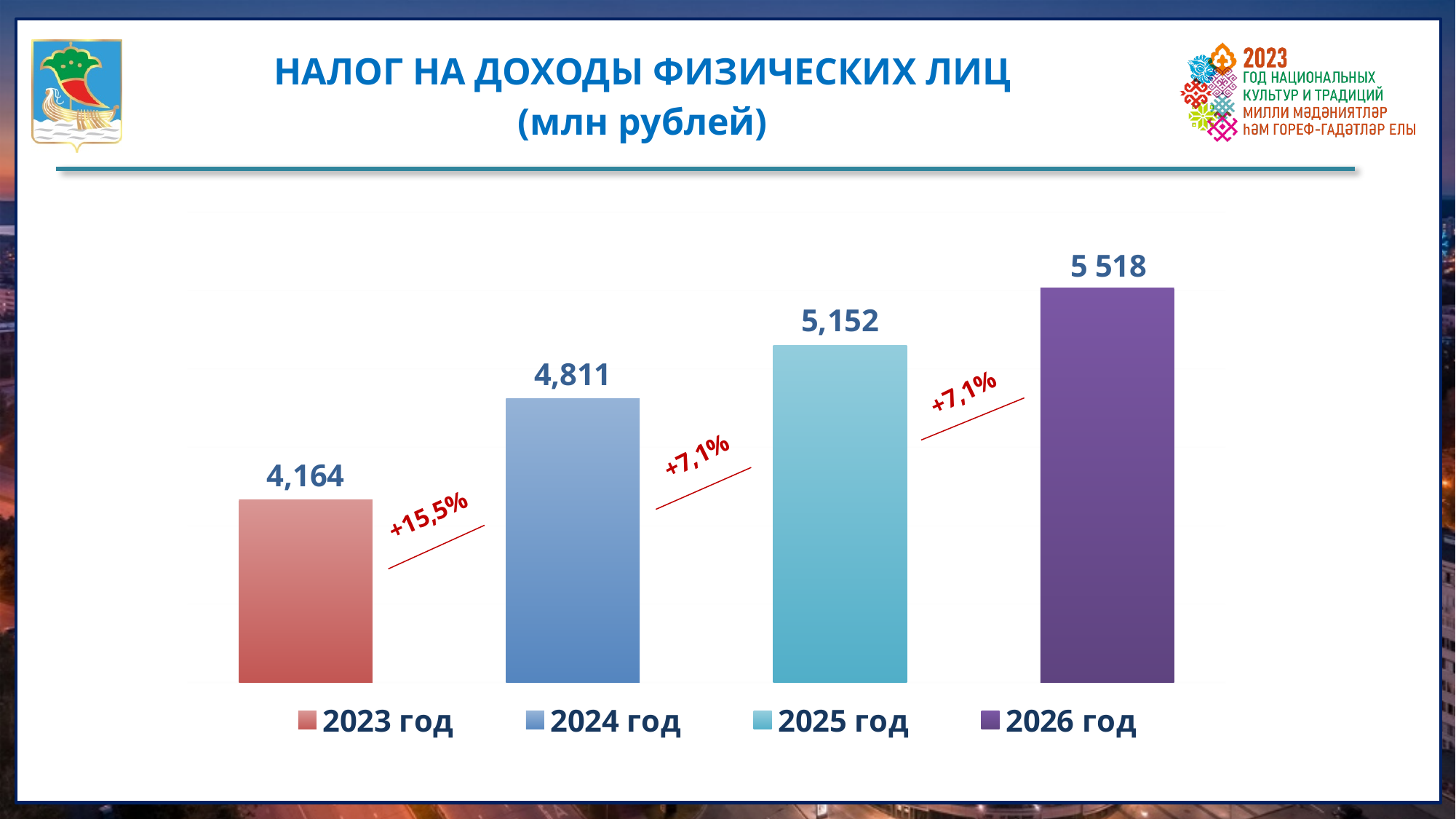
What is the value for 2023 год? 4,164 What is the value for 2024 год? 4,811 Do the values rise or fall from 2023 год to 2026 год? rise How many bars are shown in the chart? 4 Which year has the lowest value? 2023 год What is the difference between the values for 2026 год and 2025 год? 366 What is the value for 2025 год? 5,152 What is the value for 2026 год? 5 518 Which year has the highest value? 2026 год What is the difference between the values for 2024 год and 2023 год? 647 Which is larger, the value for 2025 год or the value for 2024 год? 2025 год What kind of chart is shown on the slide? bar chart